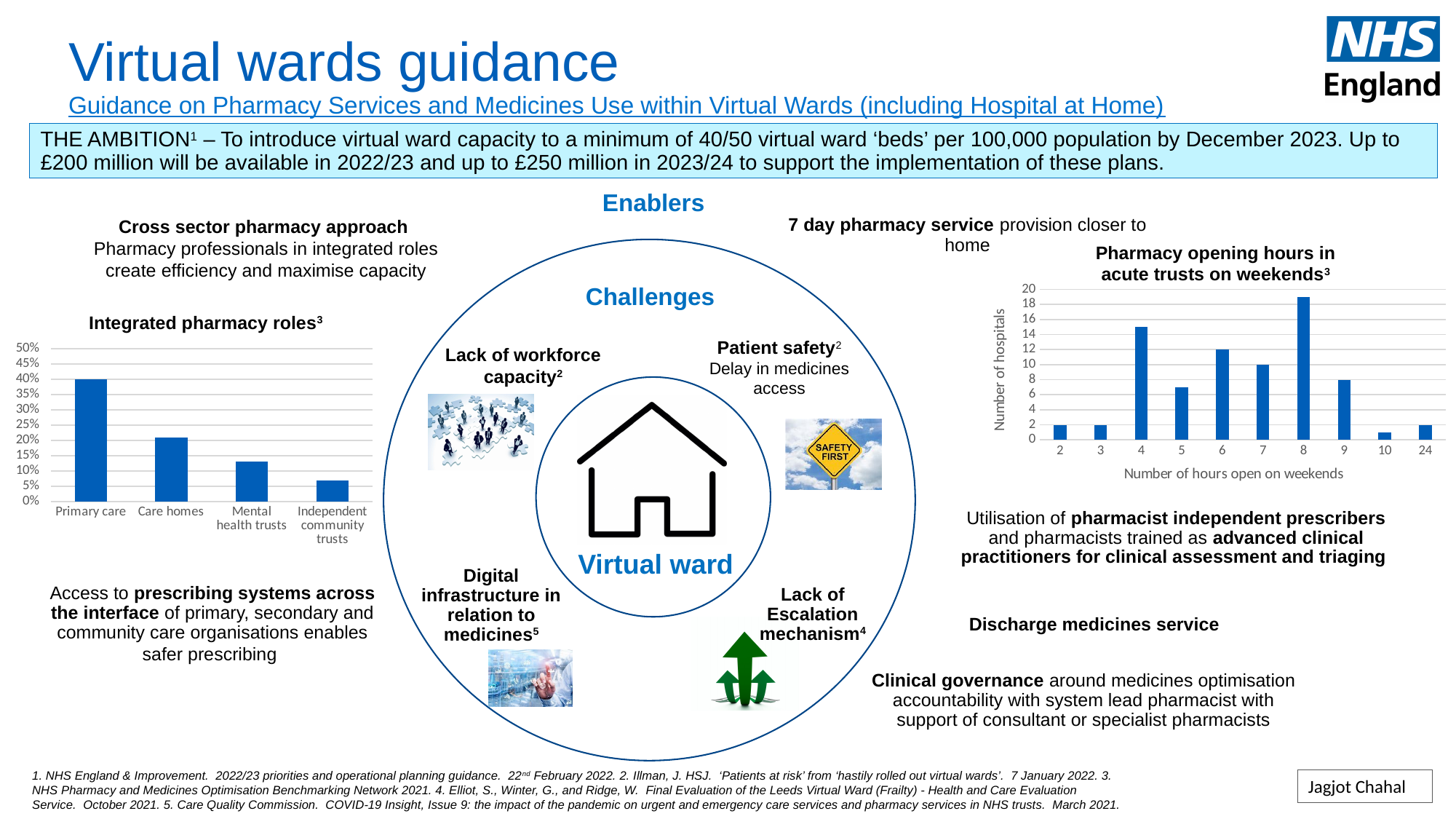
In the 'Pharmacy opening hours in acute trusts on weekends' chart, which number of hours open on weekends has the highest number of hospitals? 8 What kind of chart is the 'Pharmacy opening hours in acute trusts on weekends' chart? Bar chart What is the label on the vertical axis of the 'Pharmacy opening hours in acute trusts on weekends' chart? Number of hospitals In the 'Integrated pharmacy roles' chart, is the value for Mental health trusts greater or less than 15%? less How many categories are shown in the 'Integrated pharmacy roles' chart? 4 What kind of chart is the 'Integrated pharmacy roles' chart on the left of the slide? Bar chart In the 'Pharmacy opening hours in acute trusts on weekends' chart, is the number of hospitals open for 4 hours greater or less than 14? greater In the 'Integrated pharmacy roles' chart, which category has the lowest value? Independent community trusts In the 'Integrated pharmacy roles' chart, is the value for Care homes greater or less than 15%? greater In the 'Pharmacy opening hours in acute trusts on weekends' chart, how many hospitals are open for 6 hours on weekends? 12 In the 'Integrated pharmacy roles' chart, which category has the highest value? Primary care How many bars are shown in the 'Pharmacy opening hours in acute trusts on weekends' chart? 10